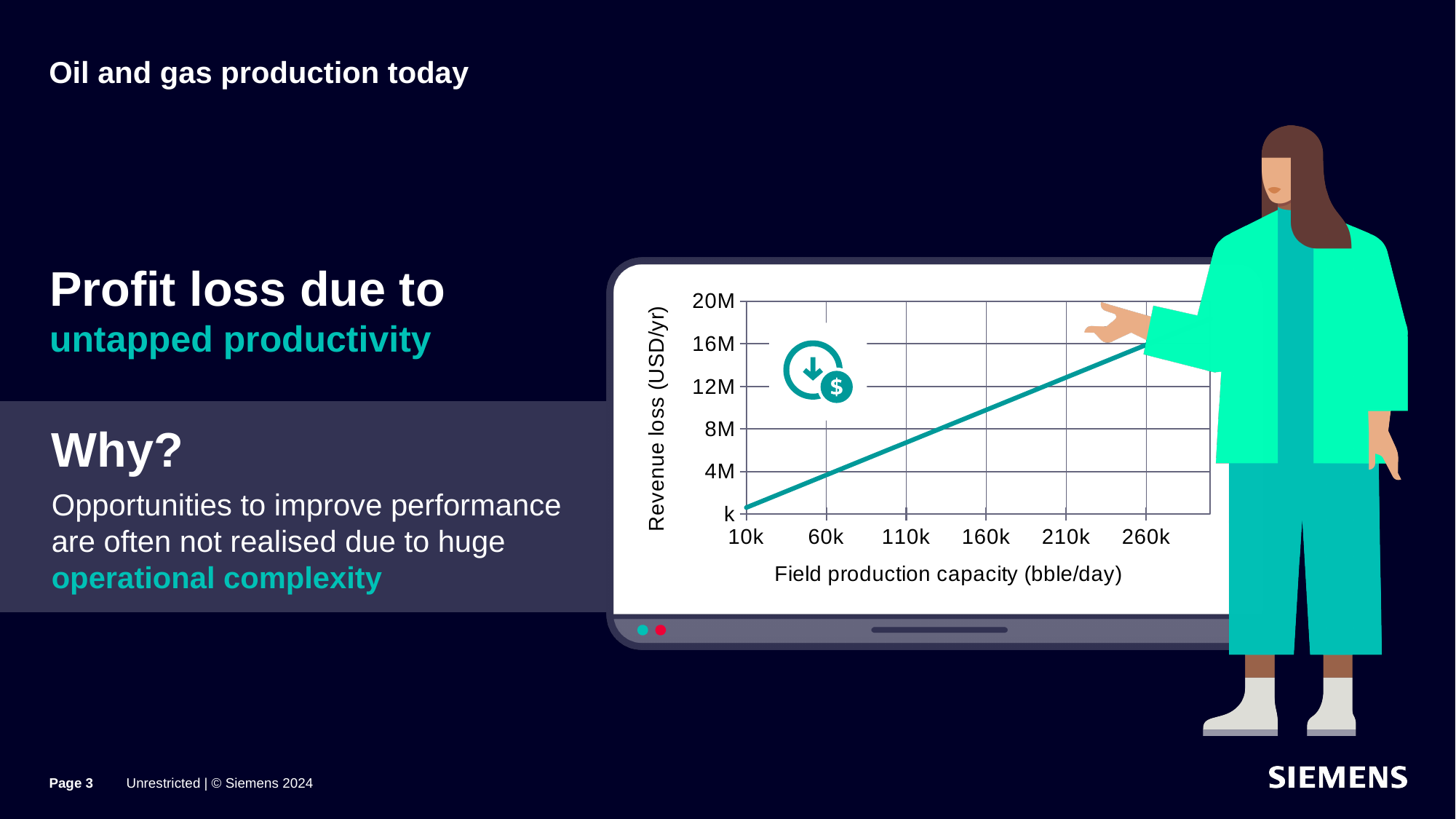
What is the label of the y axis of the chart? Revenue loss (USD/yr) At which field production capacity shown on the x axis is the revenue loss highest? 260k What kind of chart is shown on the slide? line chart Is the revenue loss at a field production capacity of 210k greater or less than 8M? greater Is the revenue loss at a field production capacity of 110k greater or less than 8M? less Is the revenue loss at a field production capacity of 110k greater or less than 4M? greater At which field production capacity shown on the x axis is the revenue loss lowest? 10k Which has the larger revenue loss: a field production capacity of 60k or 210k? 210k What is the label of the x axis of the chart? Field production capacity (bble/day) Does revenue loss rise or fall as field production capacity increases along the x axis? rises